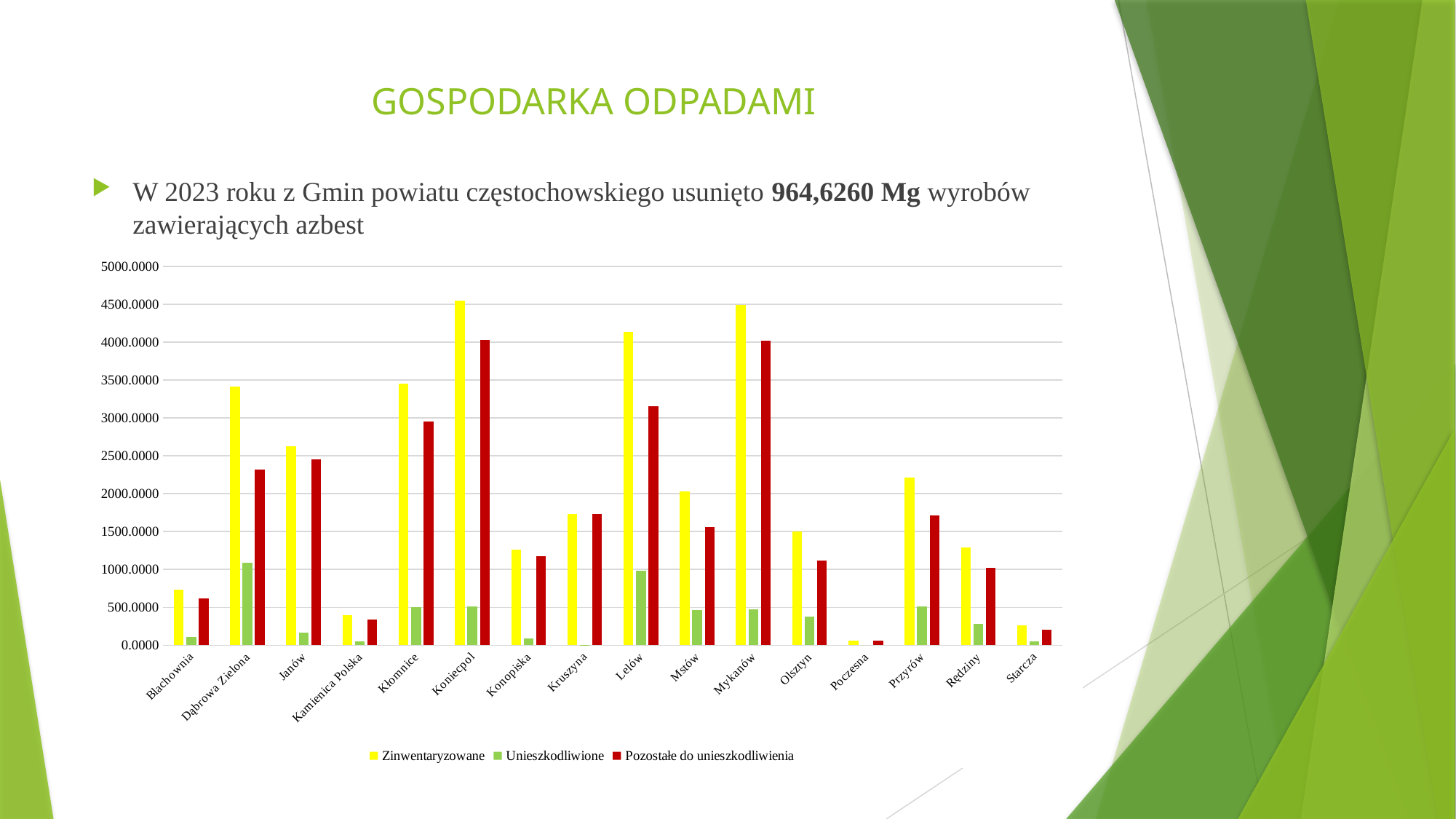
Which municipality has the highest Unieszkodliwione value? Dąbrowa Zielona Which colour represents the Pozostałe do unieszkodliwienia series in the chart? red How many series does the chart legend list? 3 Is the Pozostałe do unieszkodliwienia value for Kłomnice greater or less than 2500? greater Is the Zinwentaryzowane value for Dąbrowa Zielona greater or less than 3000? greater Is the Zinwentaryzowane value for Kamienica Polska greater or less than 500? less Which is larger: the Pozostałe do unieszkodliwienia value for Kłomnice or for Konopiska? Kłomnice Which municipality has the lowest Zinwentaryzowane value? Poczesna What kind of chart is shown on the slide? bar chart Which is larger: the Zinwentaryzowane value for Lelów or for Dąbrowa Zielona? Lelów How many municipalities (categories) are shown on the x axis of the chart? 16